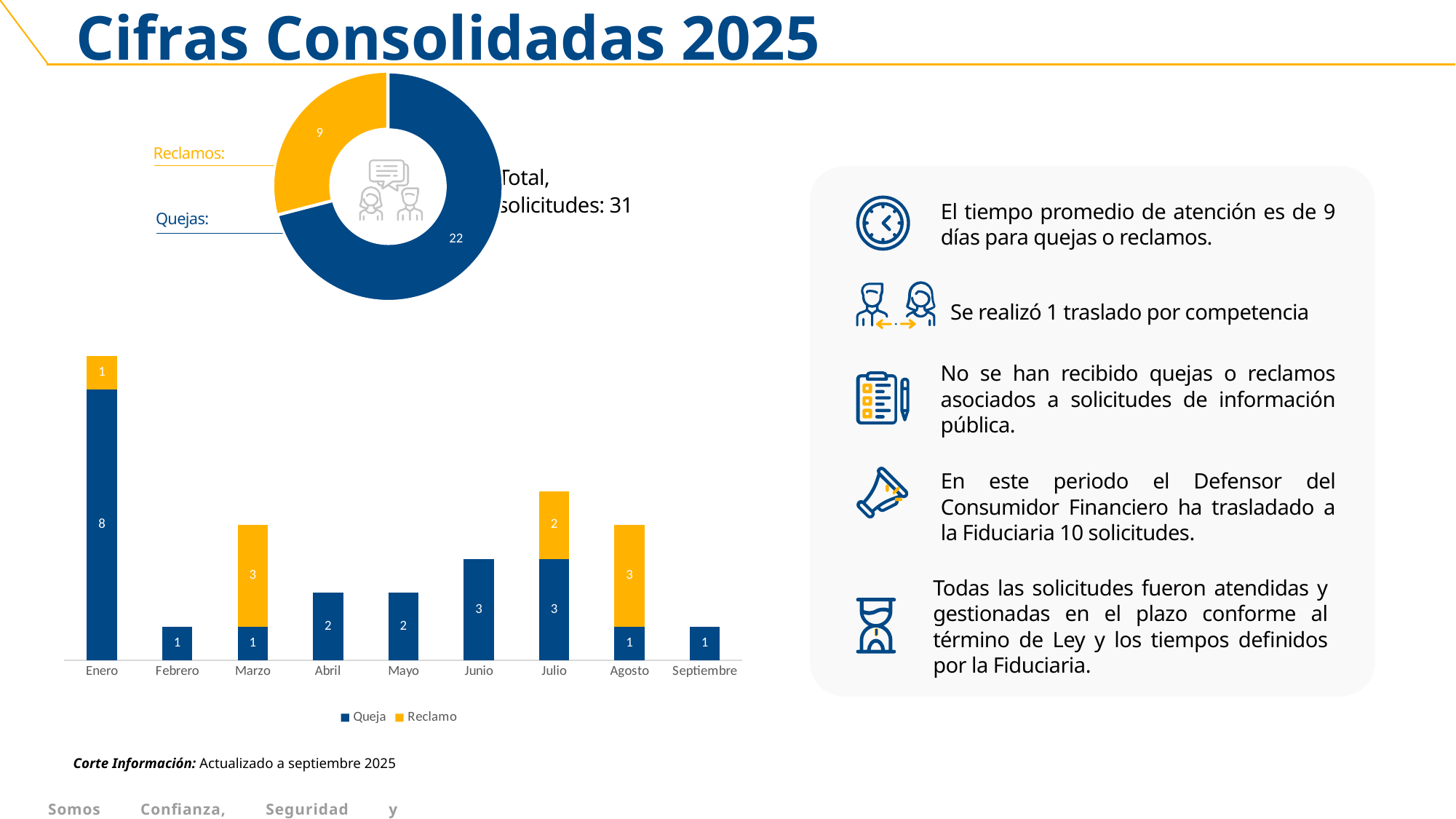
What kind of chart is the chart at the bottom of the slide? Stacked bar chart In the bar chart at the bottom, what is the Queja value for Enero? 8 In the donut chart at the top, what is the value for Reclamos? 9 In the donut chart at the top, what share of the total do Quejas represent (22 out of 31)? 71% In the donut chart at the top, what is the difference between Quejas and Reclamos? 13 In the bar chart at the bottom, what is the total of the stacked bar for Enero? 9 In the bar chart at the bottom, which month has the highest Queja value? Enero In the bar chart at the bottom, what is the total of the stacked bar for Julio? 5 In the donut chart at the top, what is the value for Quejas? 22 In the bar chart at the bottom, how many series does the legend list? 2 In the bar chart at the bottom, what is the Reclamo value for Agosto? 3 In the bar chart at the bottom, how many months are shown on the x axis? 9